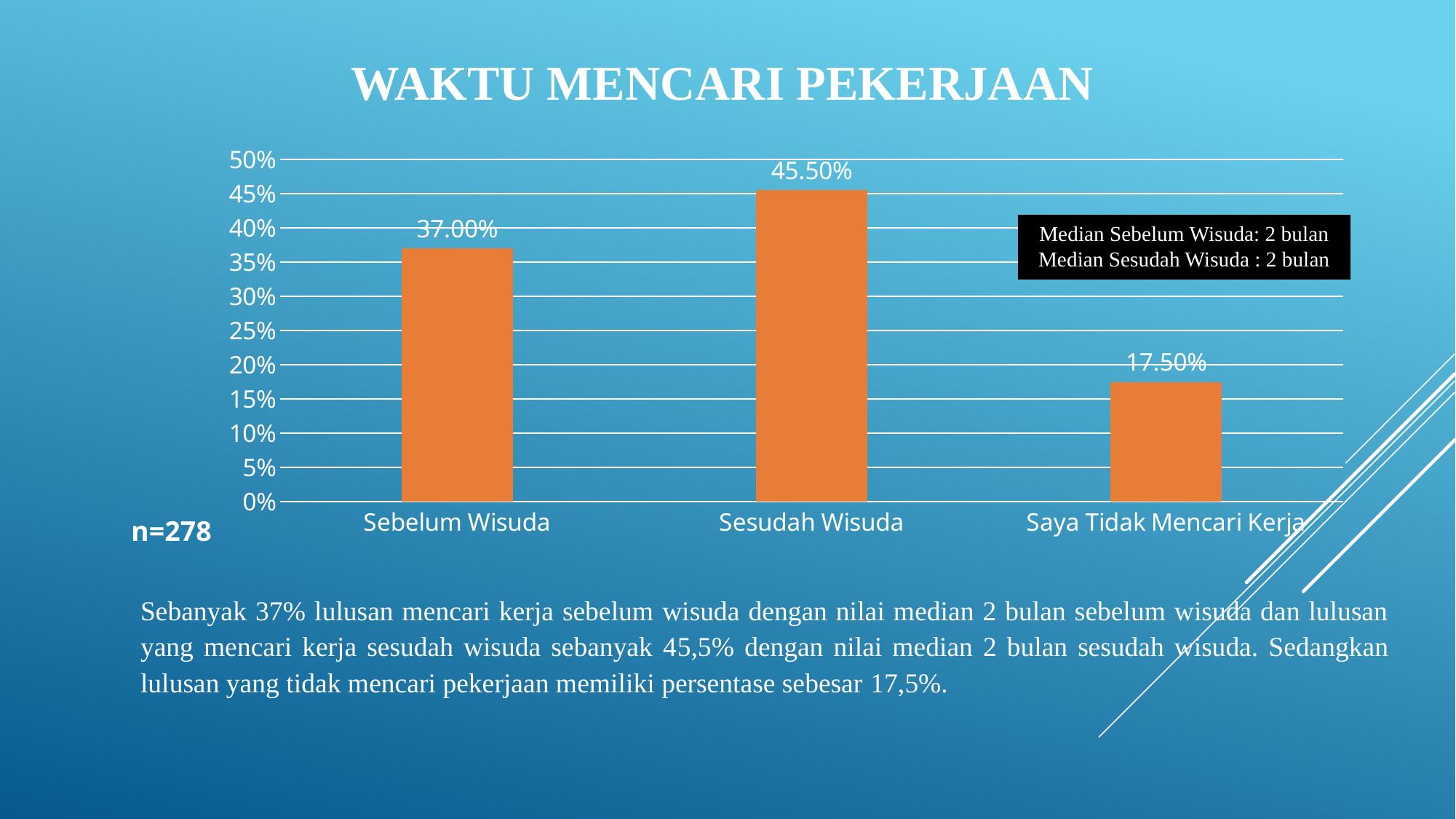
What is the title of the chart? WAKTU MENCARI PEKERJAAN What is the difference between the values for Sesudah Wisuda and Sebelum Wisuda? 8.50% What is the value for Saya Tidak Mencari Kerja? 17.50% What is the value for Sebelum Wisuda? 37.00% How many categories are shown on the x axis? 3 What is the value for Sesudah Wisuda? 45.50% Which category has the highest value? Sesudah Wisuda Which is larger, the value for Sebelum Wisuda or the value for Saya Tidak Mencari Kerja? Sebelum Wisuda What is the difference between the values for Sebelum Wisuda and Saya Tidak Mencari Kerja? 19.50% What kind of chart is shown on the slide? bar chart Is the value for Sesudah Wisuda greater or less than 40%? greater Which category has the lowest value? Saya Tidak Mencari Kerja